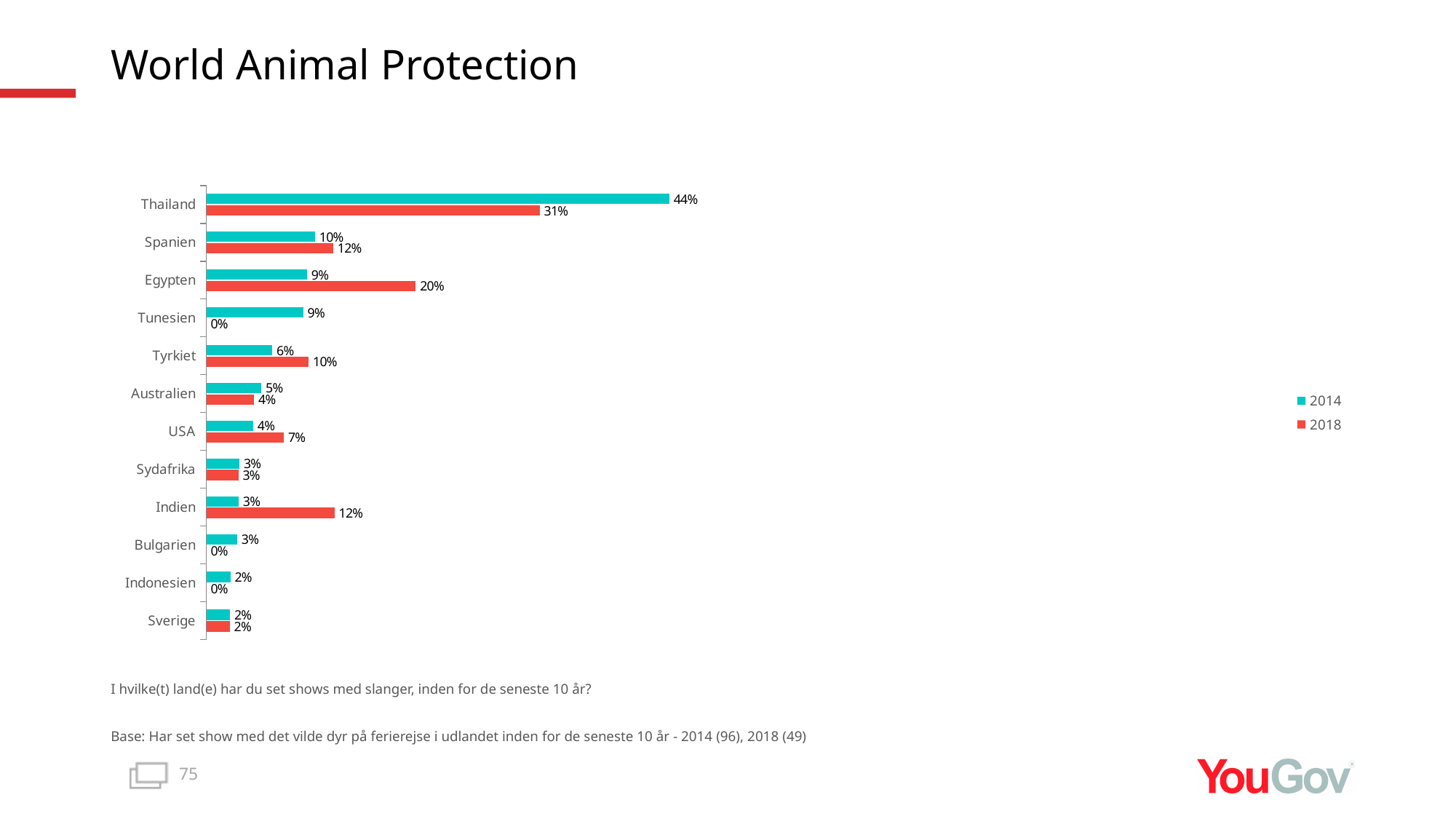
How many countries are shown on the chart? 12 What is the difference between the 2018 and 2014 values for Indien? 9% What is the 2018 value for Tunesien? 0% For Australien, which is larger: the 2014 value or the 2018 value? 2014 What is the difference between the 2014 and 2018 values for Thailand? 13% What is the 2018 value for Egypten? 20% For Egypten, which is larger: the 2014 value or the 2018 value? 2018 How many series does the legend list? 2 What kind of chart is shown on the slide? Bar chart Which country has the highest 2018 value? Thailand What is the 2014 value for Thailand? 44% Which country has the highest 2014 value? Thailand